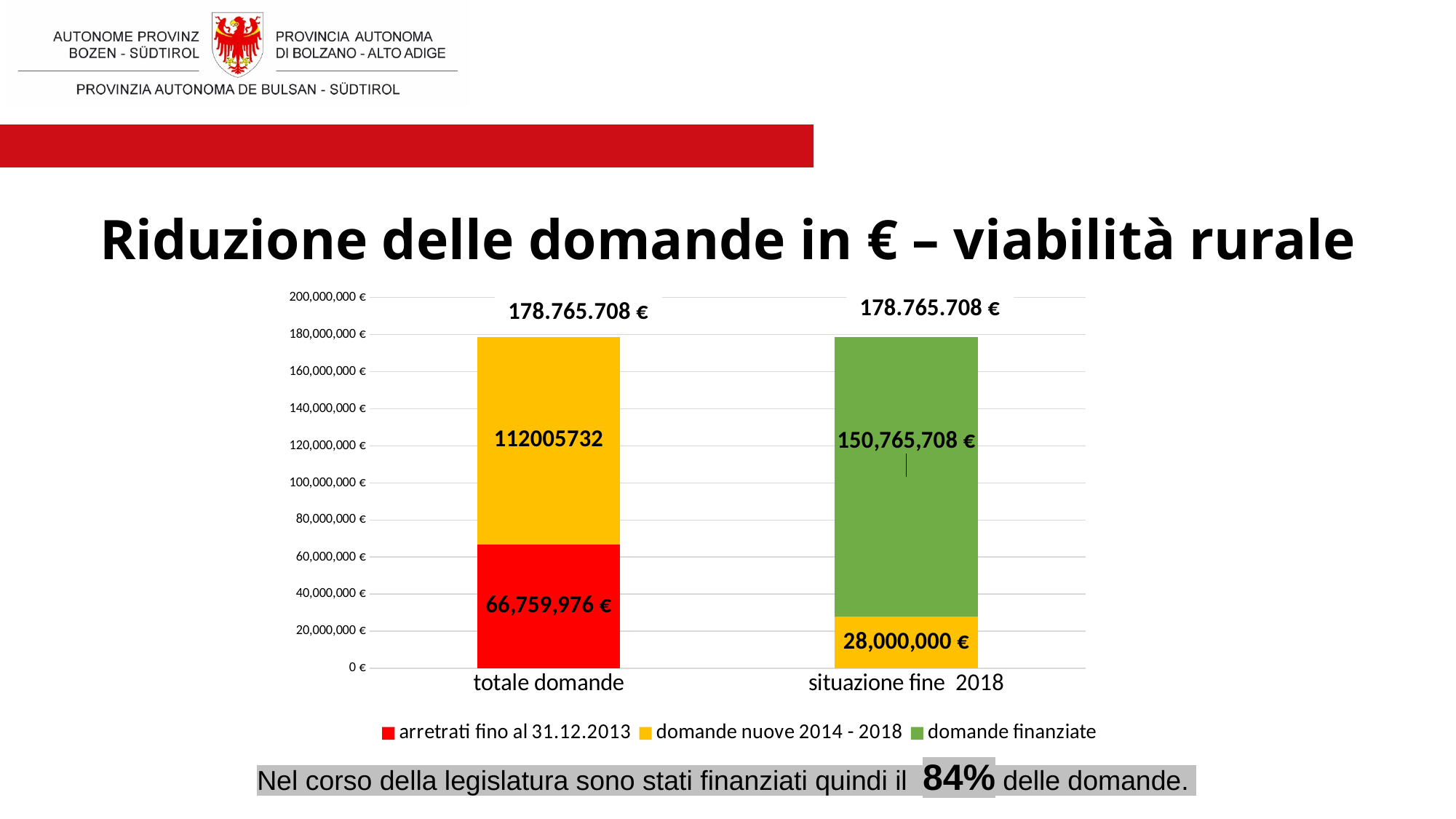
How many series does the legend list? 3 What is the title of the chart? Riduzione delle domande in € – viabilità rurale Which is larger for 'situazione fine 2018': 'domande finanziate' or 'domande nuove 2014 - 2018'? domande finanziate Which colour represents 'domande finanziate' in the chart? green What is the value of 'domande nuove 2014 - 2018' for 'situazione fine 2018'? 28,000,000 € What is the value of 'domande finanziate' for 'situazione fine 2018'? 150,765,708 € What kind of chart is shown on the slide? stacked bar chart What is the total of the 'totale domande' stacked bar? 178.765.708 € What is the value of 'domande nuove 2014 - 2018' for 'totale domande'? 112005732 Is the value of 'arretrati fino al 31.12.2013' for 'totale domande' greater or less than 60,000,000 €? greater How many categories are shown on the x axis? 2 What is the value of 'arretrati fino al 31.12.2013' for 'totale domande'? 66,759,976 €